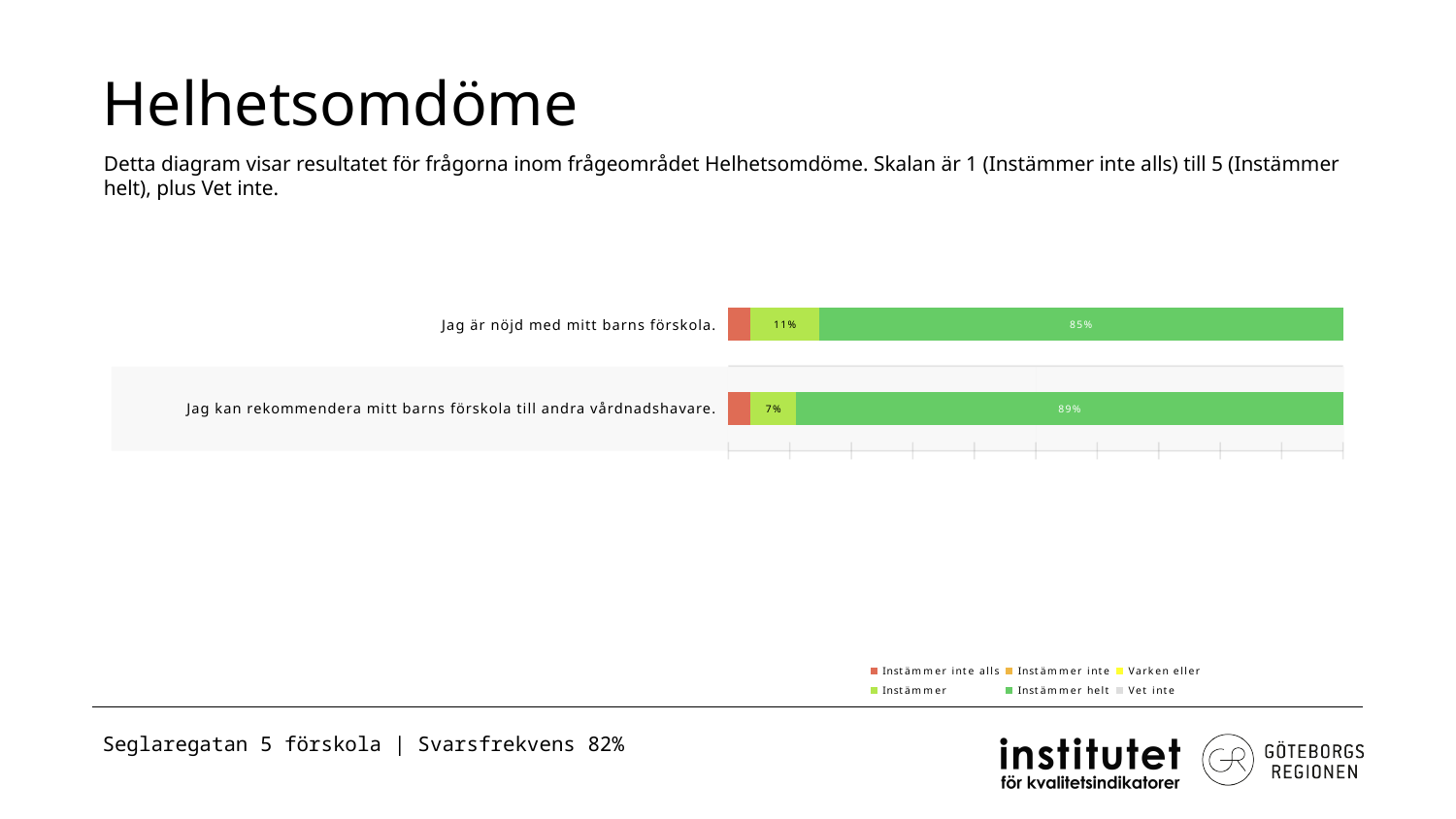
What is the value of the 'Instämmer helt' segment for 'Jag är nöjd med mitt barns förskola.'? 85% What is the difference in percentage points between the 'Instämmer helt' values of the two statements? 4 percentage points Which statement has the higher 'Instämmer helt' share? Jag kan rekommendera mitt barns förskola till andra vårdnadshavare. What is the title of the slide containing the chart? Helhetsomdöme How many statements (categories) are shown in the chart? 2 What is the value of the 'Instämmer' segment for 'Jag är nöjd med mitt barns förskola.'? 11% What is the value of the 'Instämmer' segment for 'Jag kan rekommendera mitt barns förskola till andra vårdnadshavare.'? 7% How many series does the legend list? 6 What kind of chart is shown on the slide? Stacked bar chart Which statement has the lower 'Instämmer' share? Jag kan rekommendera mitt barns förskola till andra vårdnadshavare. Is the 'Instämmer' value larger for 'Jag är nöjd med mitt barns förskola.' or for 'Jag kan rekommendera mitt barns förskola till andra vårdnadshavare.'? Jag är nöjd med mitt barns förskola. What is the value of the 'Instämmer helt' segment for 'Jag kan rekommendera mitt barns förskola till andra vårdnadshavare.'? 89%